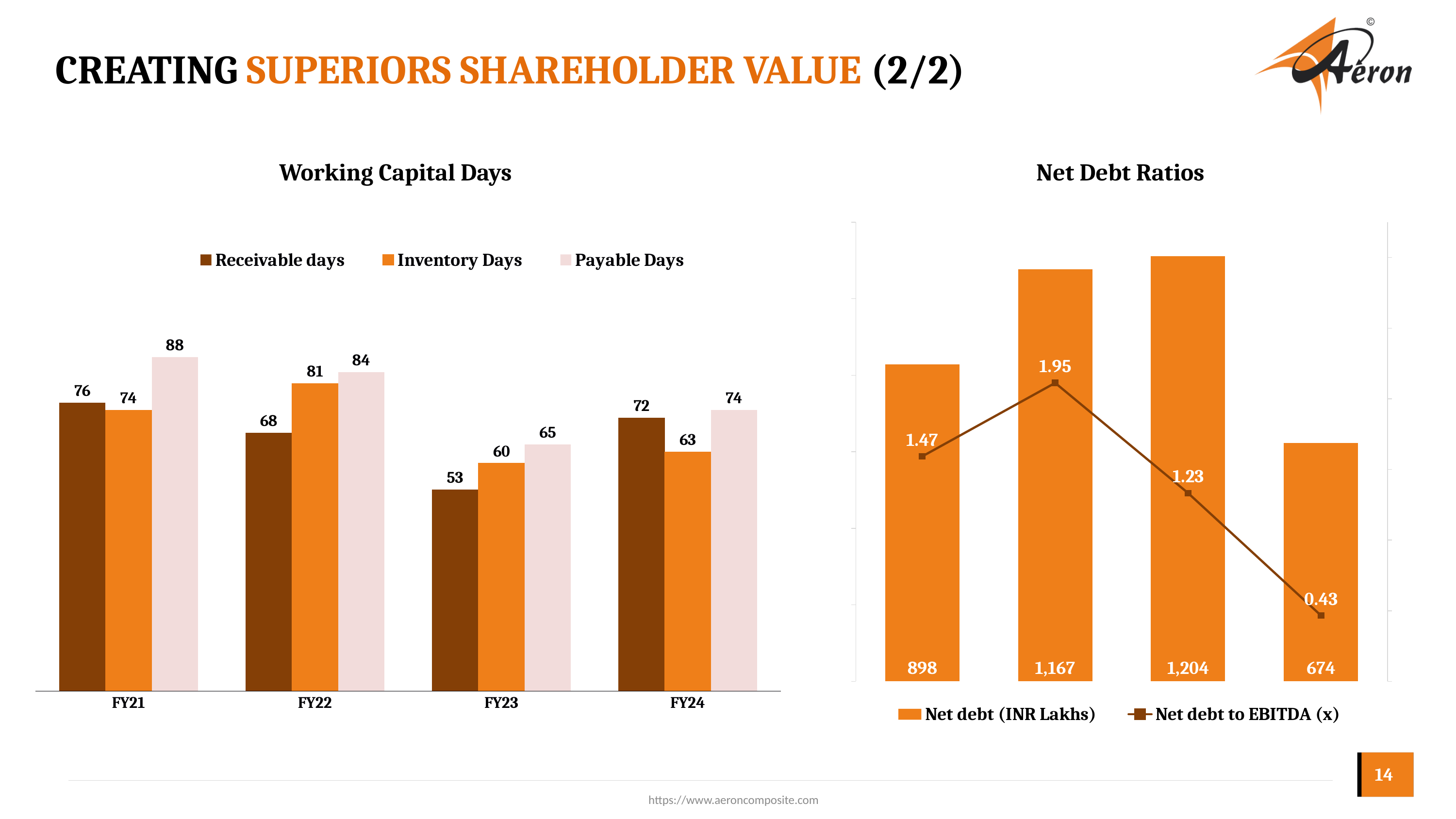
In the Working Capital Days chart, which is larger in FY24: Receivable days or Inventory Days? Receivable days In the Working Capital Days chart, what is the value of Payable Days for FY21? 88 In the Working Capital Days chart, what is the value of Receivable days for FY23? 53 What kind of chart is the Working Capital Days chart? Bar chart How many series does the legend of the Working Capital Days chart list? 3 In the Working Capital Days chart, which fiscal year has the highest Payable Days? FY21 In the Working Capital Days chart, what is the value of Inventory Days for FY22? 81 In the Working Capital Days chart, what is the difference between Payable Days and Receivable days in FY22? 16 In the Net Debt Ratios chart, what is the highest Net debt (INR Lakhs) value shown? 1,204 In the Working Capital Days chart, which fiscal year has the lowest Receivable days? FY23 How many fiscal years are shown on the x axis of the Working Capital Days chart? 4 In the Net Debt Ratios chart, what is the lowest Net debt to EBITDA (x) value shown? 0.43